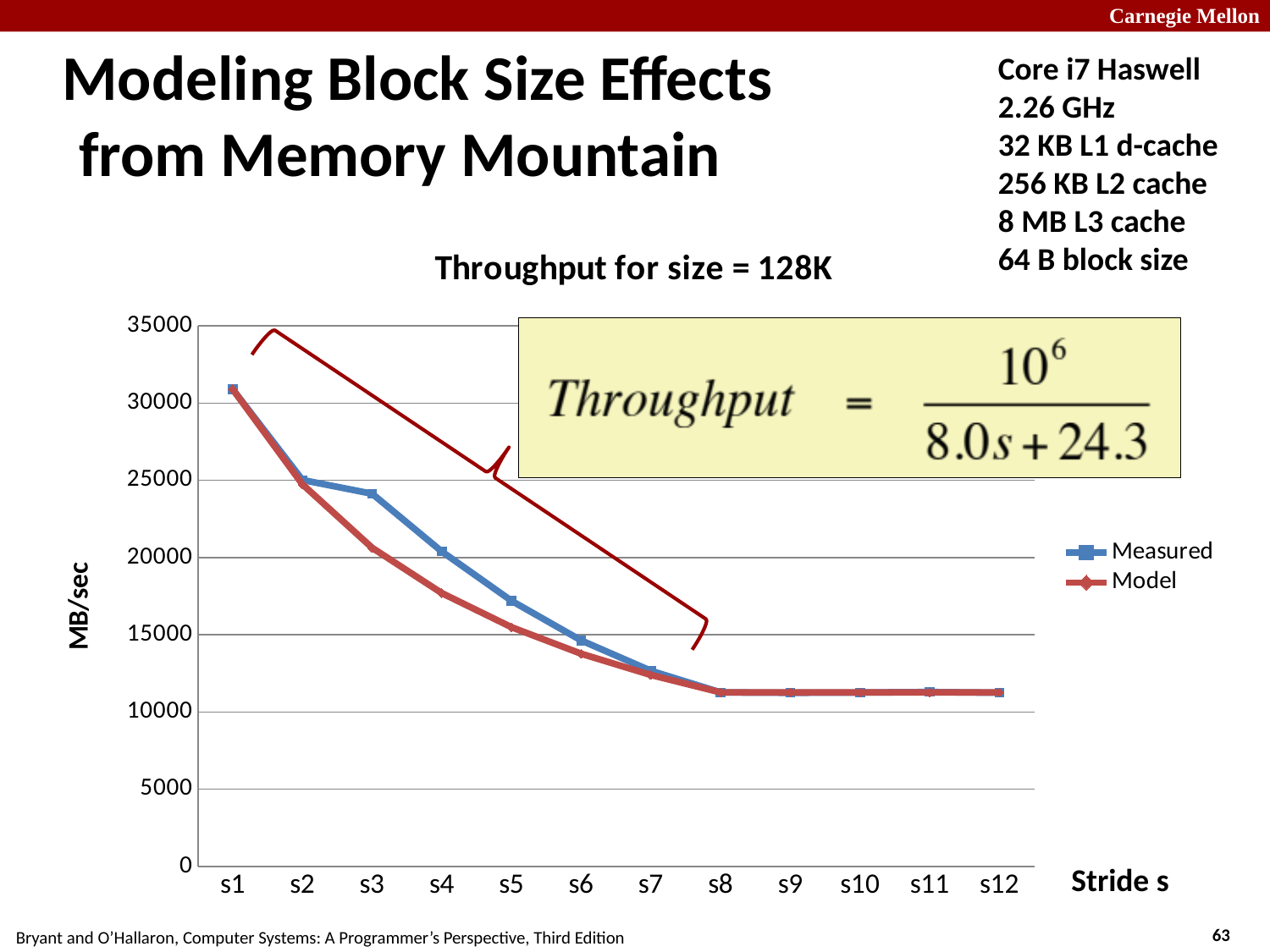
Is the Model value at s4 greater or less than 20000? less What kind of chart is shown on the slide? line chart Which stride has the highest Measured throughput? s1 Do the Measured values rise or fall as the stride increases from s1 to s12? fall Is the Measured value at s8 greater or less than 15000? less Is the Measured value at s1 greater or less than 25000? greater How many stride values are plotted along the x axis? 12 At stride s3, which series has the larger value, Measured or Model? Measured How many series does the legend list? 2 What are the two series named in the legend? Measured and Model What is the title of the chart? Throughput for size = 128K